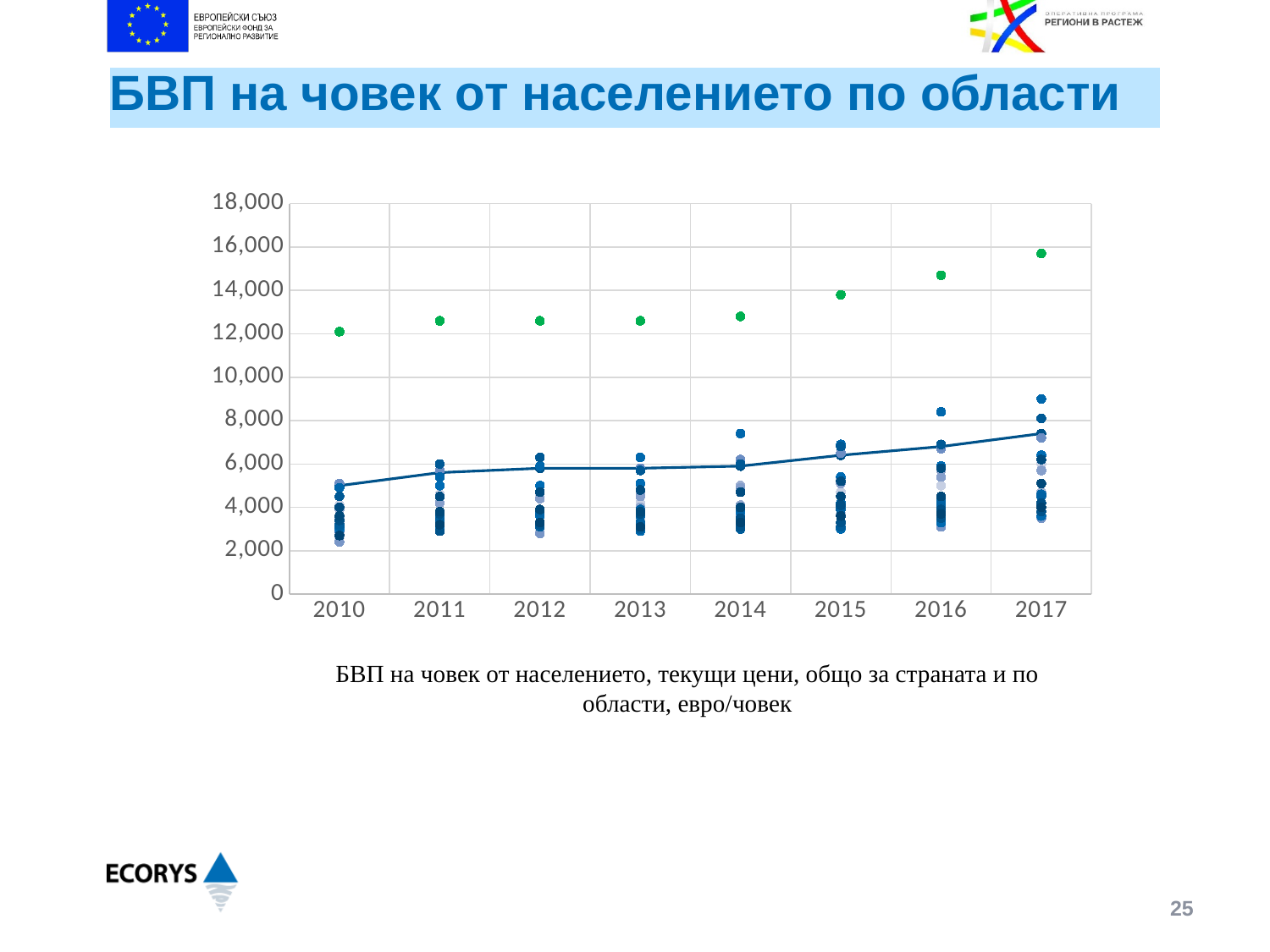
Is the value of the solid line for 2010 greater or less than 6,000? less Is the green point for 2010 greater or less than 10,000? greater In which year is the green point at its lowest? 2010 Is the value of the solid line for 2017 greater or less than 6,000? greater In which year is the green point at its highest? 2017 How many years are shown on the x axis of the chart? 8 What is the first year shown on the x axis of the chart? 2010 What is the highest value labelled on the y axis of the chart? 18,000 Do the green points rise or fall from 2010 to 2017? rise